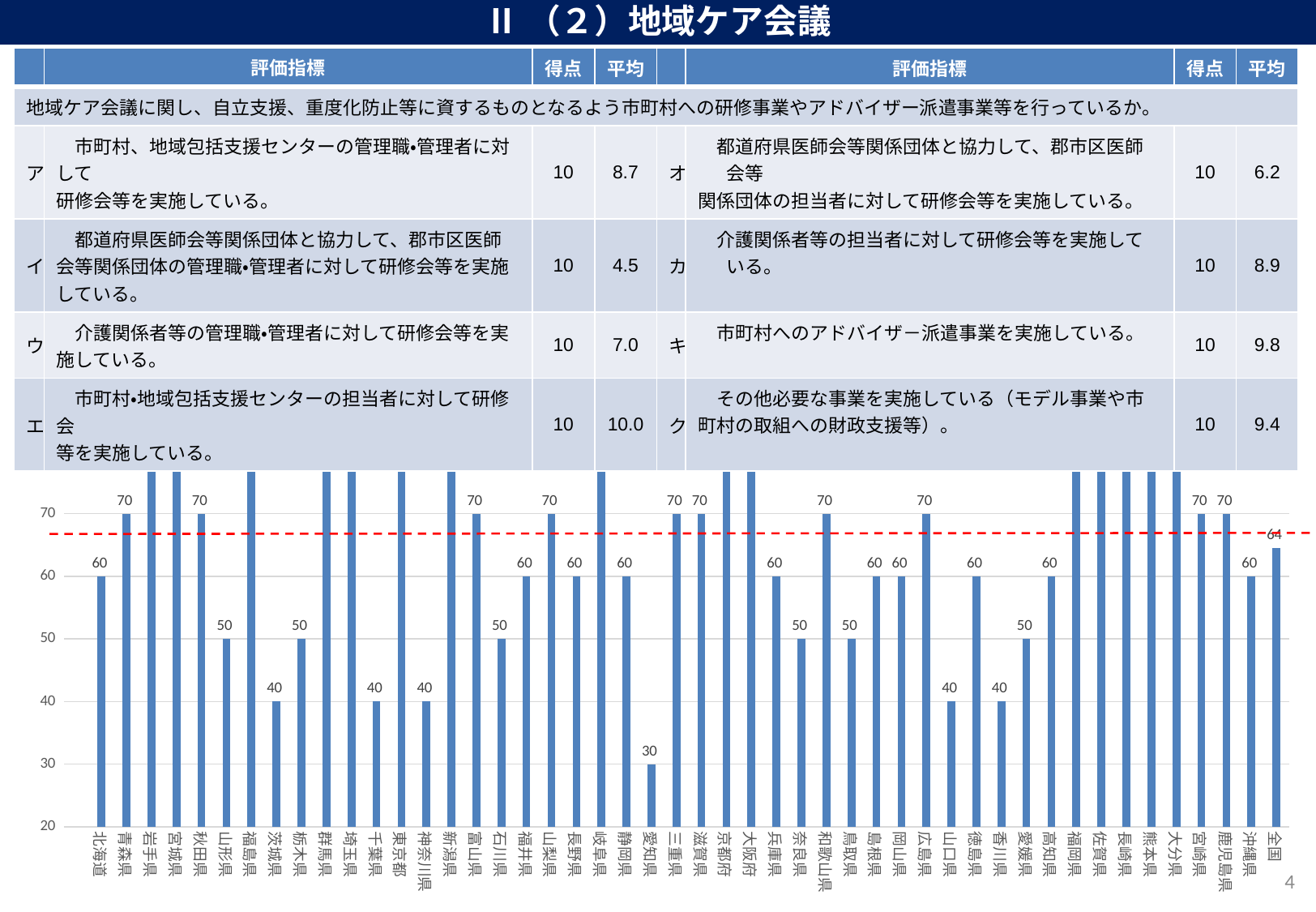
Is the value for 大阪府 greater or less than 70? greater Which has a larger value, 茨城県 or 福井県? 福井県 What is the value for 全国 in the bar chart? 64 Which category has the lowest value in the bar chart? 愛知県 Is the value for 岩手県 greater or less than 70? greater What kind of chart is shown at the bottom of the slide? bar chart What colour is the dashed horizontal line drawn across the bar chart? red What is the difference between the values for 青森県 and 山形県? 20 What is the value for 愛知県 in the bar chart? 30 What is the difference between the values for 全国 and 沖縄県? 4 What is the value for 北海道 in the bar chart? 60 How many categories are shown on the x axis of the bar chart? 48